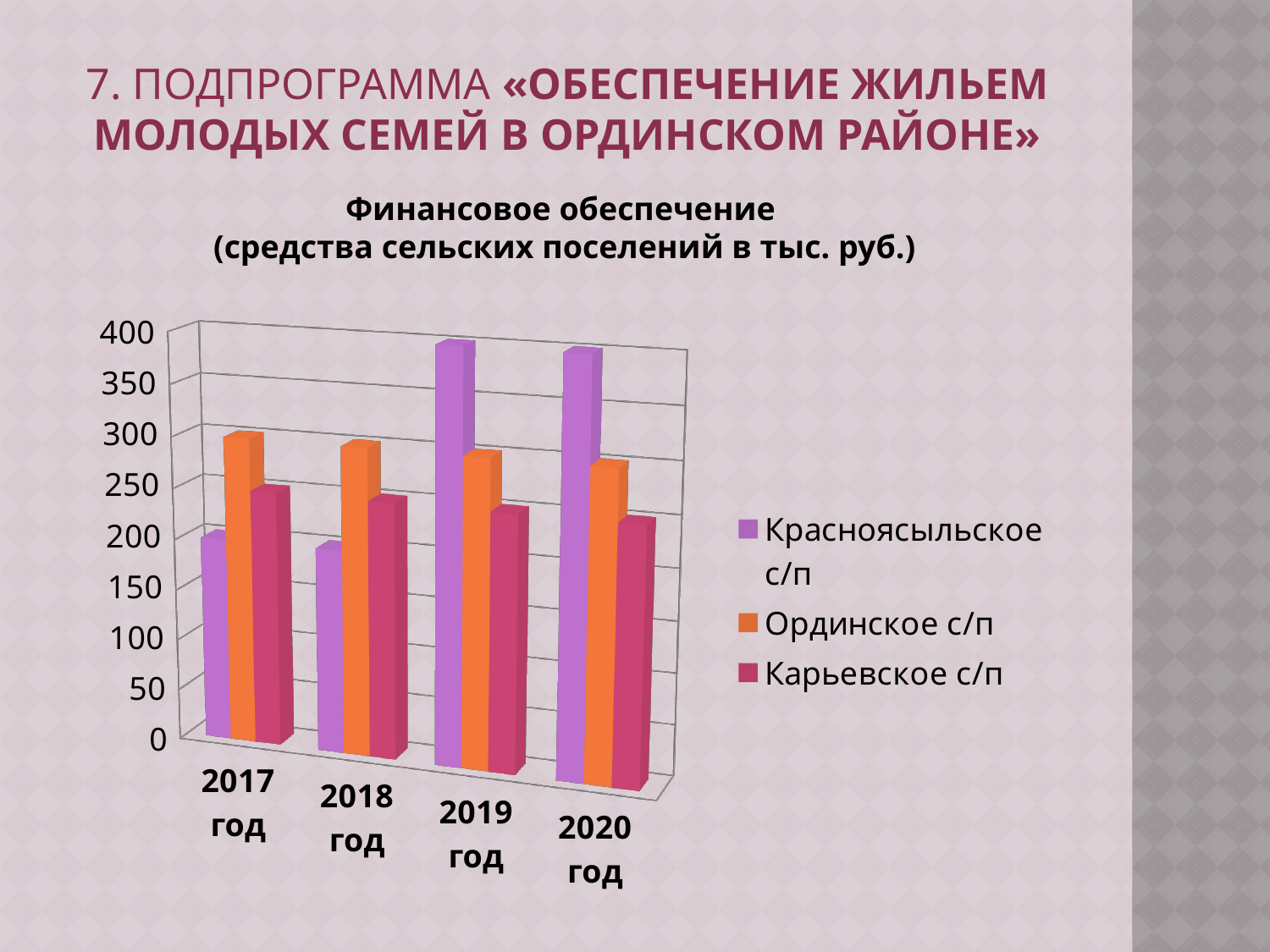
In 2017 год, which is larger: Ординское с/п or Красноясыльское с/п? Ординское с/п How many years are shown on the x axis? 4 What is the title of the chart? Финансовое обеспечение (средства сельских поселений в тыс. руб.) What kind of chart is shown on the slide? bar chart Is the value for Красноясыльское с/п in 2017 год greater or less than 250? less In 2019 год, which is larger: Красноясыльское с/п or Ординское с/п? Красноясыльское с/п Is the value for Ординское с/п in 2017 год greater or less than 250? greater How many series does the legend list? 3 Is the value for Красноясыльское с/п in 2019 год greater or less than 350? greater Which colour represents Ординское с/п in the legend? orange